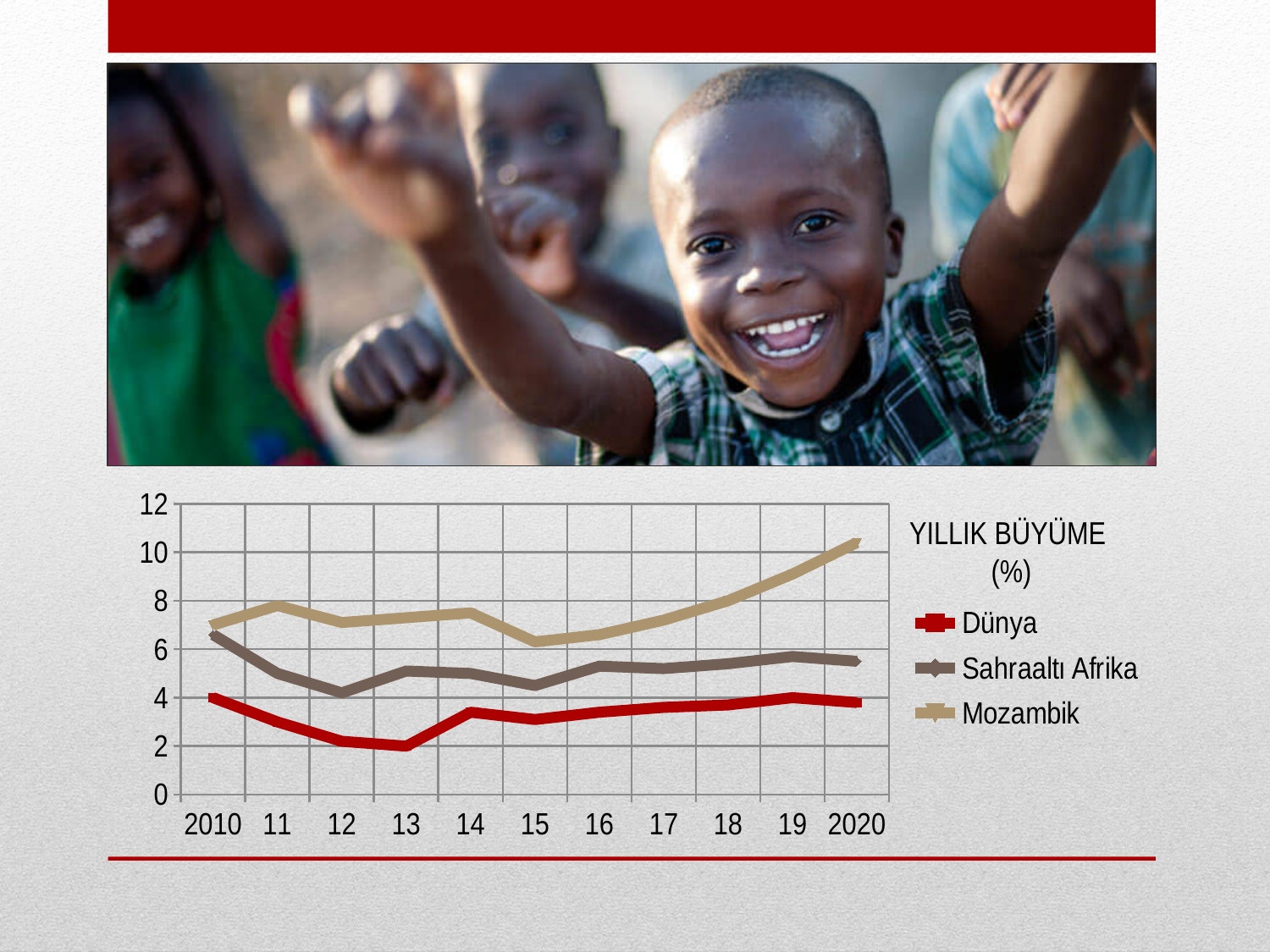
Which series has the lowest value in 2020? Dünya How many series does the chart legend list? 3 What kind of chart is shown on the slide? line chart Is the value for Dünya in 2013 greater or less than 4? less How many years are plotted along the x axis of the chart? 11 Is the value for Mozambik in 2020 greater or less than 8? greater Which series is drawn in red on the chart? Dünya Is the value for Sahraaltı Afrika in 2012 greater or less than 6? less Which series has the highest value in 2020? Mozambik What is the title of the chart? YILLIK BÜYÜME (%) Does the Mozambik line rise or fall from 2015 to 2020? rise In 2010, which is larger: the value for Sahraaltı Afrika or the value for Dünya? Sahraaltı Afrika